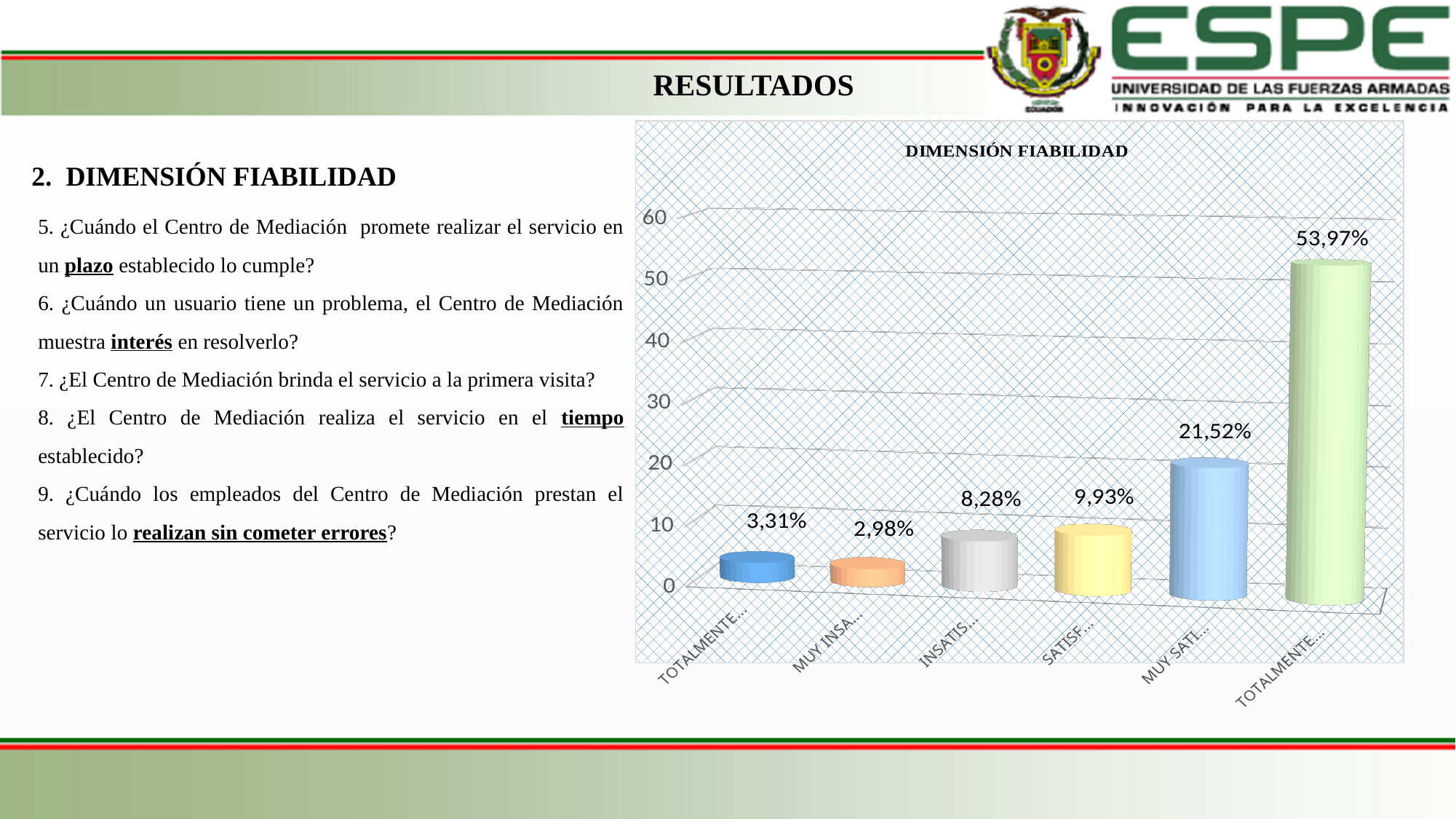
What is the value of the bar labelled 'MUY SATI...' in the DIMENSIÓN FIABILIDAD chart? 21,52% What is the value of the bar labelled 'SATISF...' in the DIMENSIÓN FIABILIDAD chart? 9,93% What is the value of the bar labelled 'INSATIS...' in the DIMENSIÓN FIABILIDAD chart? 8,28% In the DIMENSIÓN FIABILIDAD chart, what is the difference between the 'MUY SATI...' bar and the 'SATISF...' bar? 11,59% What is the value of the bar labelled 'MUY INSA...' in the DIMENSIÓN FIABILIDAD chart? 2,98% Which bar has the highest value in the DIMENSIÓN FIABILIDAD chart? the rightmost bar (TOTALMENTE..., 53,97%) Which bar has the lowest value in the DIMENSIÓN FIABILIDAD chart? MUY INSA... (2,98%) What is the value of the first (leftmost) bar in the DIMENSIÓN FIABILIDAD chart? 3,31% What type of chart is shown under the title DIMENSIÓN FIABILIDAD? bar chart In the DIMENSIÓN FIABILIDAD chart, which is larger: the 'INSATIS...' bar or the 'SATISF...' bar? SATISF... How many bars are plotted in the DIMENSIÓN FIABILIDAD chart? 6 What is the value of the last (rightmost) bar in the DIMENSIÓN FIABILIDAD chart? 53,97%